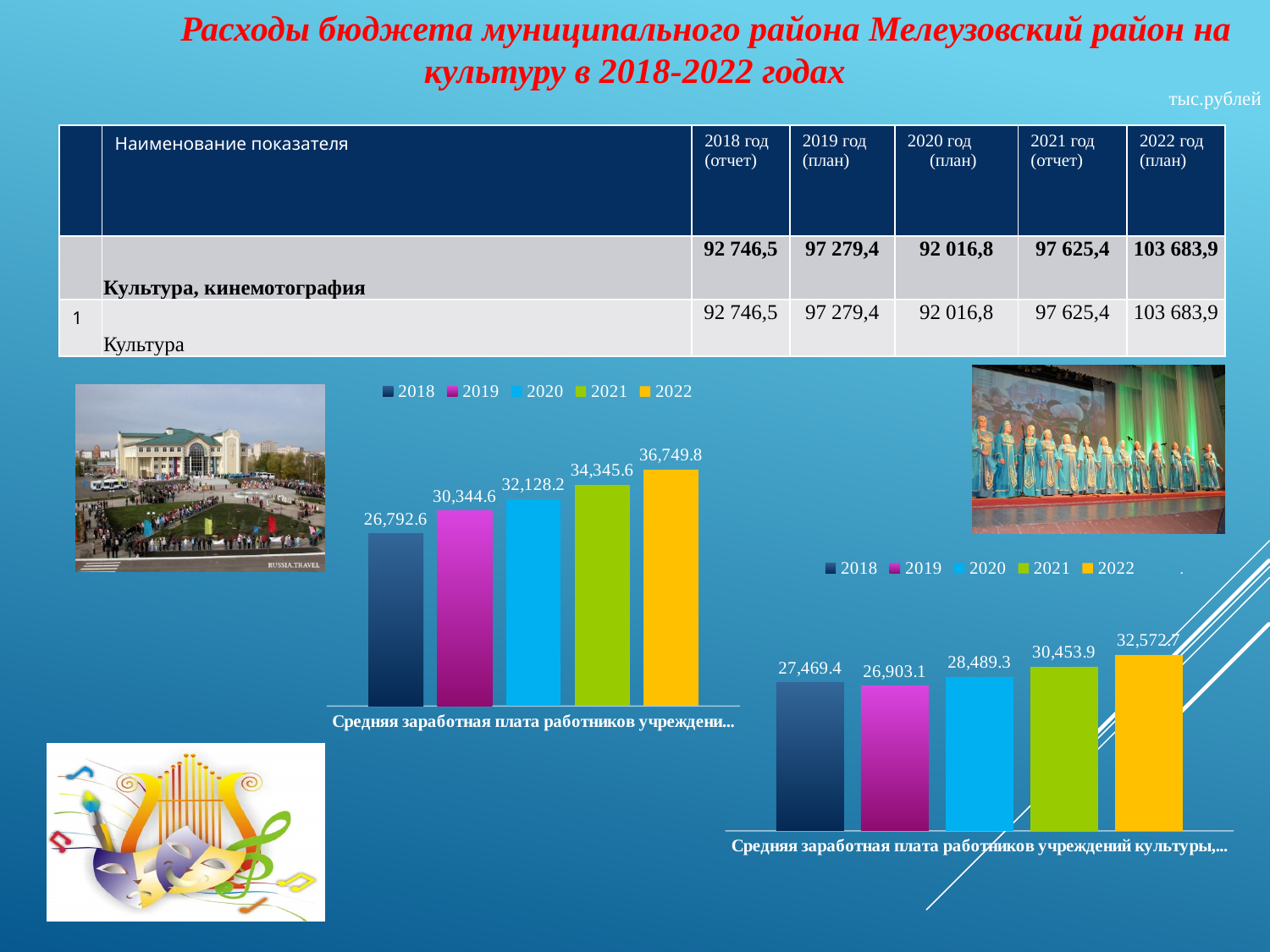
In the left chart, what is the value for 2018? 26,792.6 How many entries does the legend of the right chart list? 5 In the right chart, what is the difference between the 2022 value and the 2021 value? 2,118.8 In the left chart, what is the difference between the 2022 value and the 2018 value? 9,957.2 In the right chart, which year has the lowest value? 2019 What type of chart is the left chart? Bar chart How many bars are plotted in the left chart? 5 In the right chart, which is larger, the value for 2018 or the value for 2019? 2018 In the right chart, what is the value for 2021? 30,453.9 In the left chart, what is the value for 2022? 36,749.8 In the right chart, what is the value for 2019? 26,903.1 In the left chart, which year has the highest value? 2022